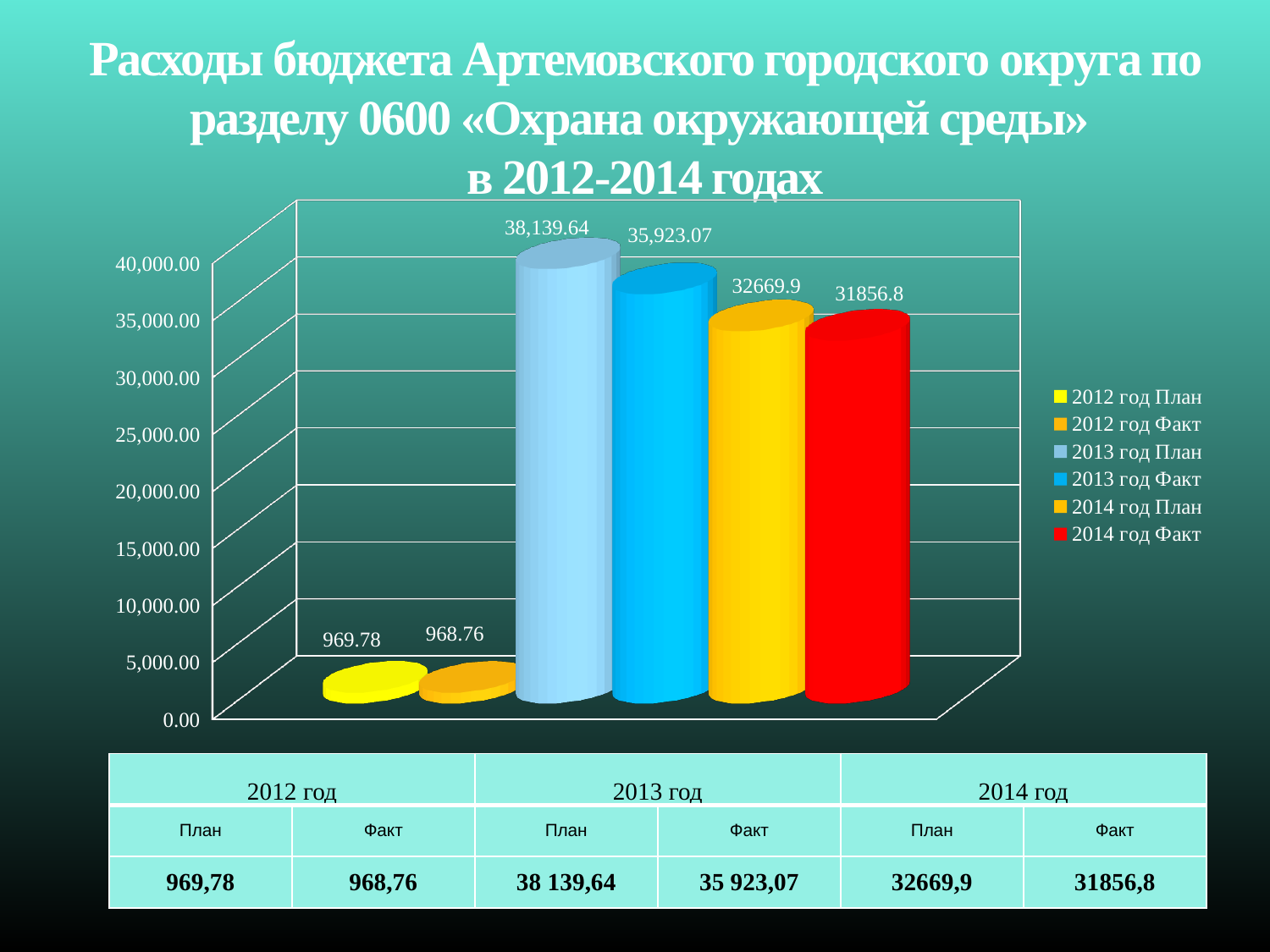
What is the difference between 2013 год План and 2013 год Факт? 2216.57 What is the difference between 2014 год План and 2014 год Факт? 813.1 What colour is the bar for 2014 год Факт? red What is the value for 2012 год План? 969.78 Which series has the highest value? 2013 год План What is the value for 2013 год Факт? 35,923.07 Which is larger, 2013 год Факт or 2014 год План? 2013 год Факт What is the value for 2013 год План? 38,139.64 What is the value for 2014 год Факт? 31856.8 How many series does the legend list? 6 What kind of chart is shown on the slide? bar chart Is the value for 2014 год Факт greater or less than 30,000.00? greater